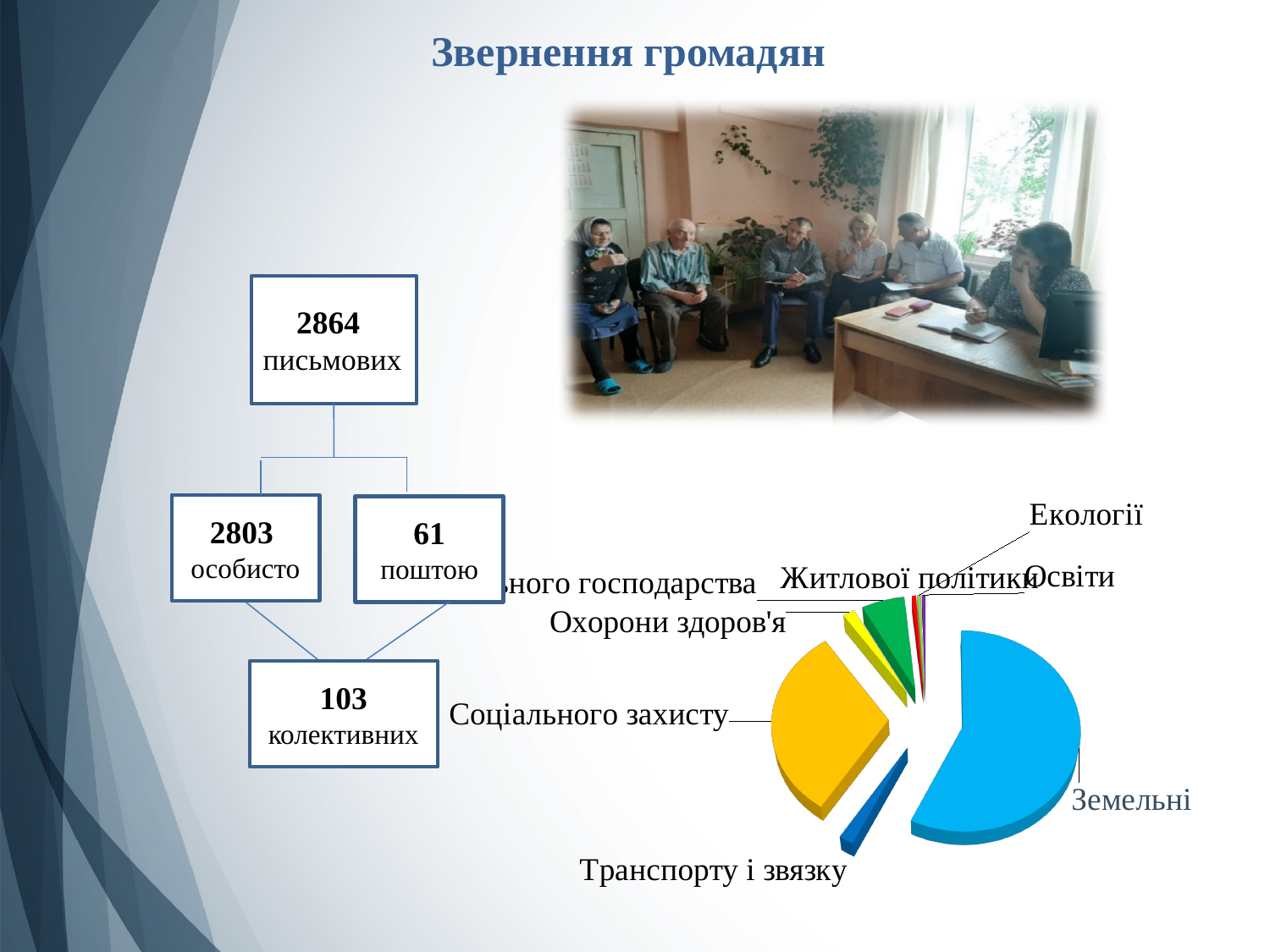
Which slice is larger in the pie chart, Соціального захисту or Транспорту і звязку? Соціального захисту What kind of chart is shown on the slide? pie chart Which slice is larger in the pie chart, Земельні or Житлової політики? Земельні Which slice is larger in the pie chart, Соціального захисту or Охорони здоров'я? Соціального захисту What colour is the Земельні slice in the pie chart? blue What colour is the Соціального захисту slice in the pie chart? yellow Which category has the largest slice in the pie chart? Земельні